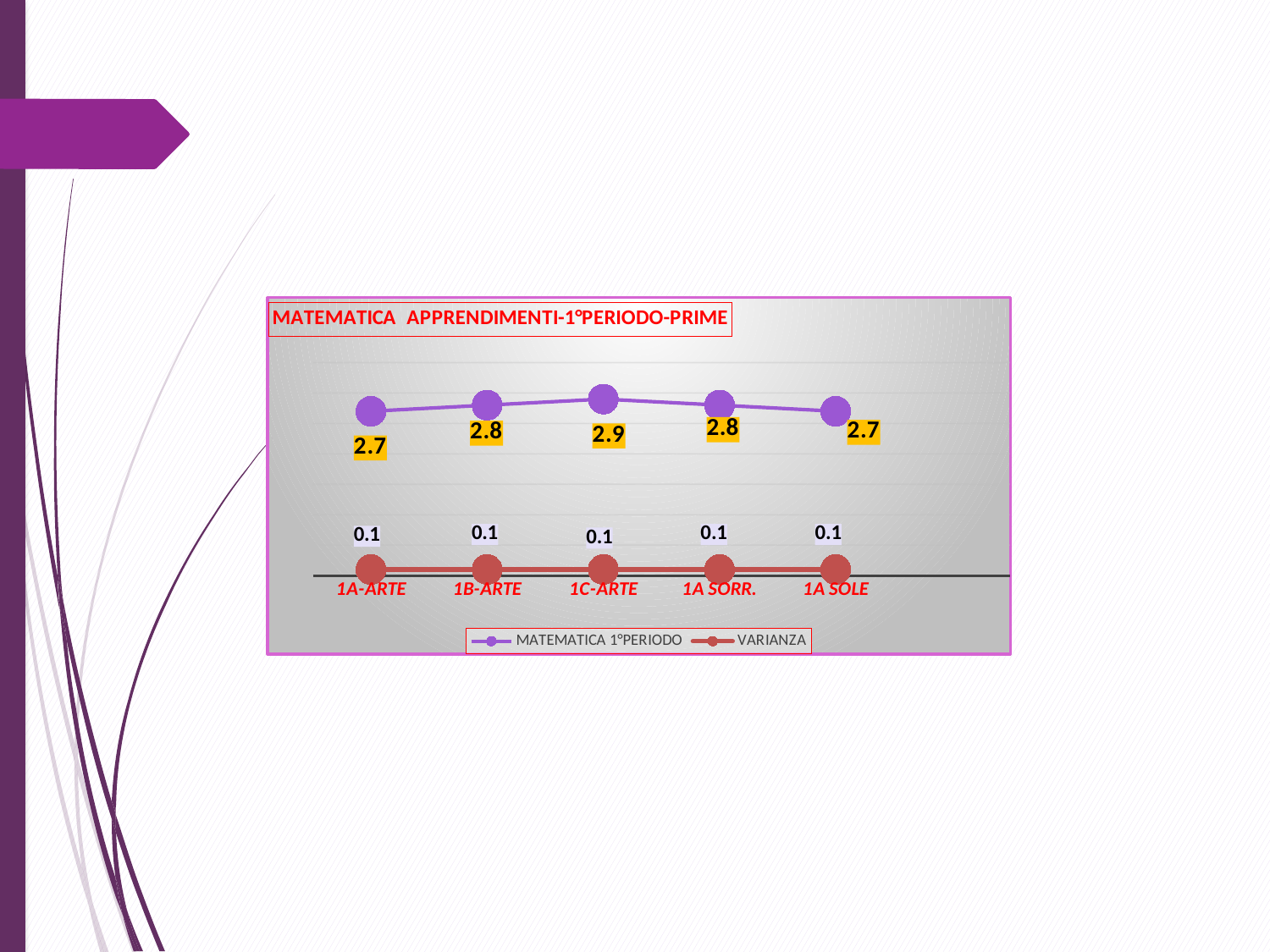
What kind of chart is shown on the slide? line chart What is the MATEMATICA 1°PERIODO value for 1C-ARTE? 2.9 What is the difference between the MATEMATICA 1°PERIODO values for 1C-ARTE and 1A-ARTE? 0.2 How many categories are shown on the x axis? 5 Does the MATEMATICA 1°PERIODO series rise or fall from 1C-ARTE to 1A SOLE? fall What is the MATEMATICA 1°PERIODO value for 1A SOLE? 2.7 What colour is the VARIANZA series line? red What is the VARIANZA value for 1B-ARTE? 0.1 Which category has the highest MATEMATICA 1°PERIODO value? 1C-ARTE How many series does the legend list? 2 What is the title of the chart? MATEMATICA APPRENDIMENTI-1°PERIODO-PRIME Which is larger, the MATEMATICA 1°PERIODO value for 1B-ARTE or for 1A SOLE? 1B-ARTE